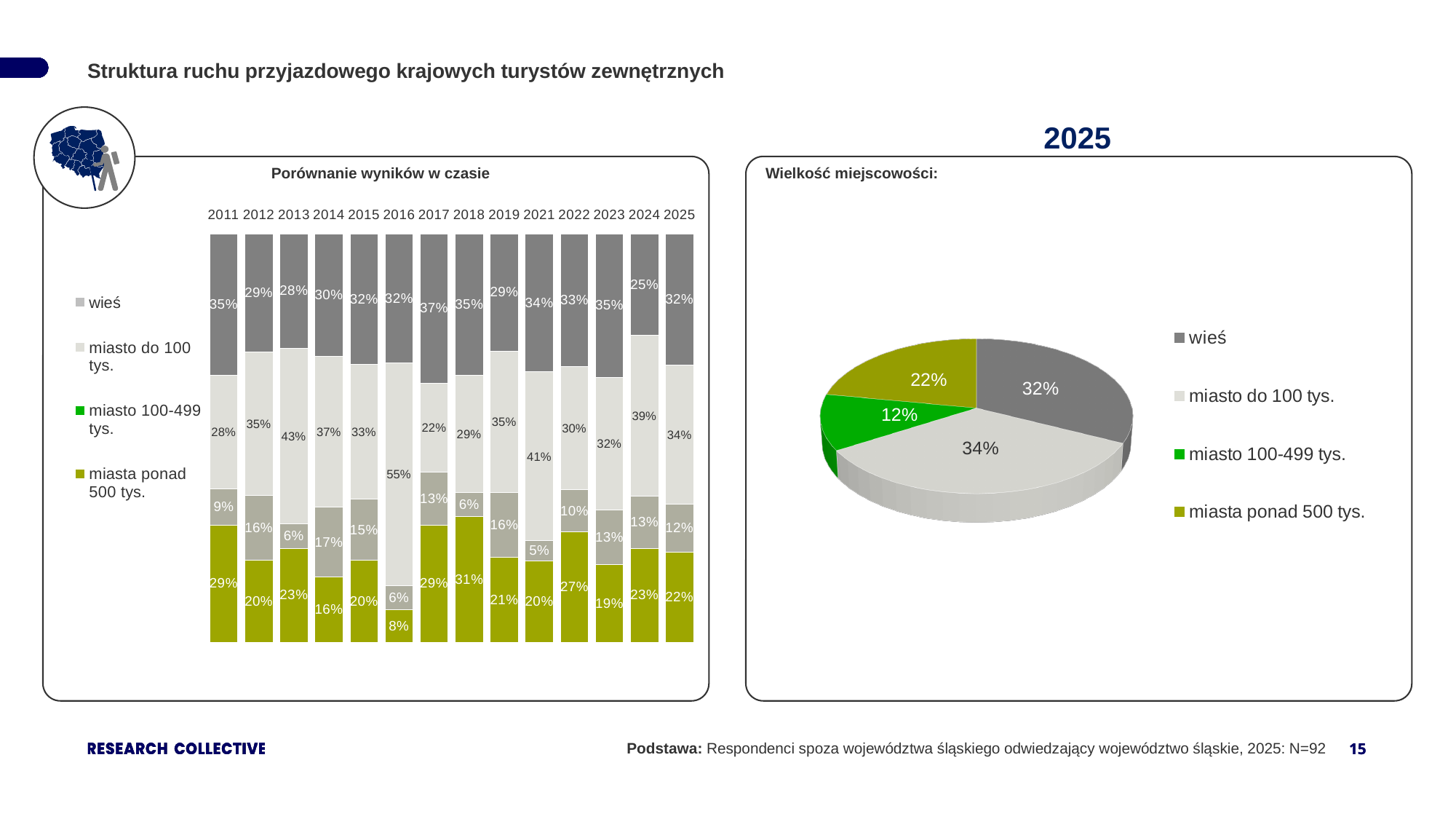
In the chart 'Porównanie wyników w czasie', how many years (bars) are shown? 14 What type of chart is 'Porównanie wyników w czasie'? Stacked bar chart In the chart 'Porównanie wyników w czasie', what is the value for 'miasto do 100 tys.' in 2016? 55% In the chart 'Porównanie wyników w czasie', in which year is the 'miasta ponad 500 tys.' segment the highest? 2018 In the pie chart 'Wielkość miejscowości' (2025), what is the value for 'miasta ponad 500 tys.'? 22% In the pie chart 'Wielkość miejscowości' (2025), how many slices are there? 4 In the chart 'Porównanie wyników w czasie', what is the value for 'wieś' in 2017? 37% In the pie chart 'Wielkość miejscowości' (2025), what share is 'miasto do 100 tys.'? 34% In the chart 'Porównanie wyników w czasie', what is the difference between the 'wieś' values for 2017 and 2024? 12 percentage points In the chart 'Porównanie wyników w czasie', in which year is the 'miasta ponad 500 tys.' segment the lowest? 2016 In the chart 'Porównanie wyników w czasie', which is larger: 'miasto 100-499 tys.' in 2014 or in 2021? 2014 In the pie chart 'Wielkość miejscowości' (2025), which category has the smallest slice? miasto 100-499 tys.